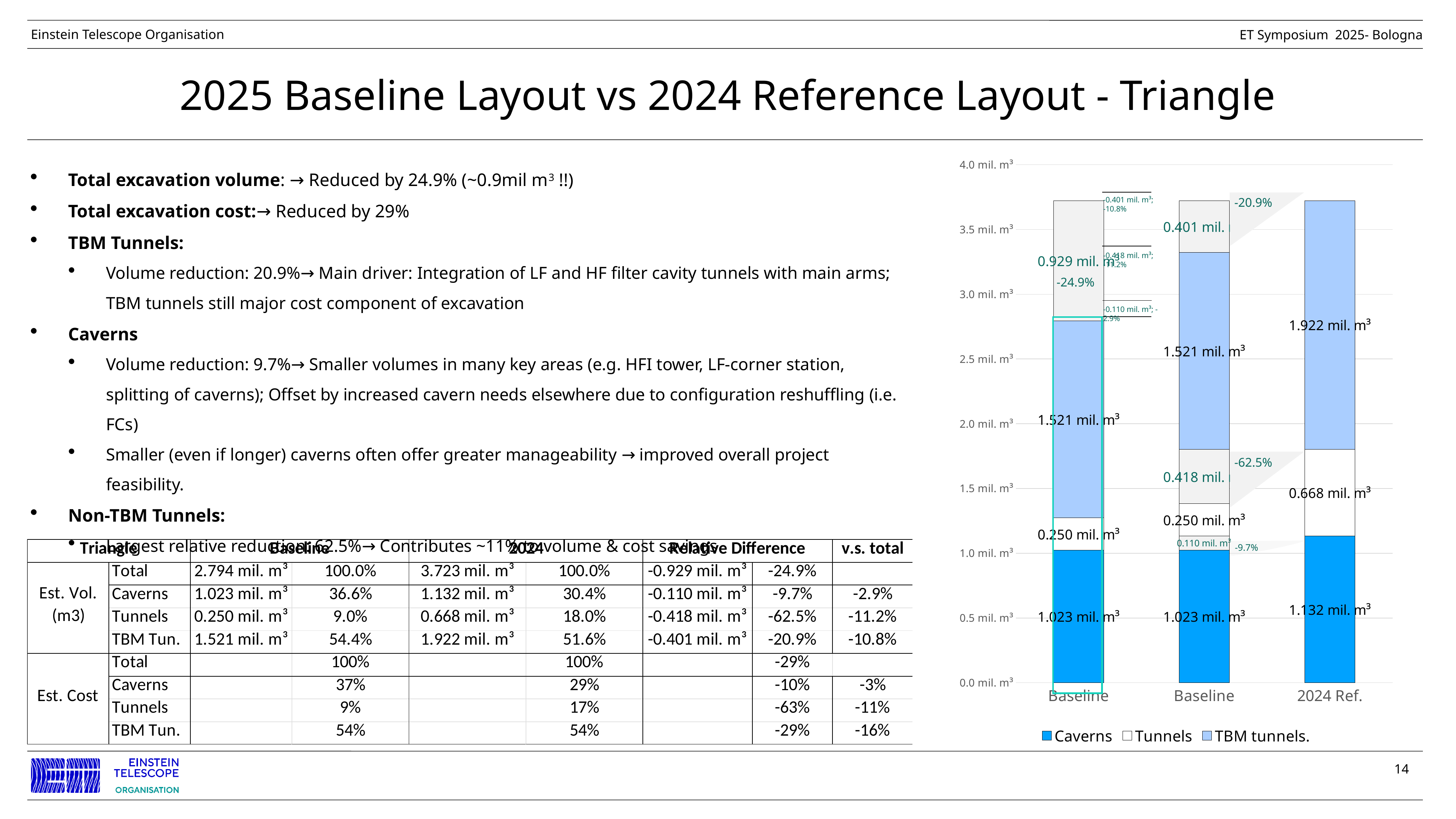
What is the TBM tunnels value for the Baseline bar? 1.521 mil. m³ What is the Caverns value for the Baseline bar? 1.023 mil. m³ What is the difference between the TBM tunnels value for 2024 Ref. and for Baseline? 0.401 mil. m³ Is the total height of the 2024 Ref. bar greater or less than 3.5 mil. m³? greater Which has the larger TBM tunnels value, Baseline or 2024 Ref.? 2024 Ref. What is the Tunnels value for the 2024 Ref. bar? 0.668 mil. m³ What kind of chart is shown on the right of the slide? bar chart What is the TBM tunnels value for the 2024 Ref. bar? 1.922 mil. m³ How many bars are plotted in the chart? 3 How many series does the chart legend list? 3 What is the Caverns value for the 2024 Ref. bar? 1.132 mil. m³ What is the total of the stacked Baseline bar (Caverns + Tunnels + TBM tunnels)? 2.794 mil. m³